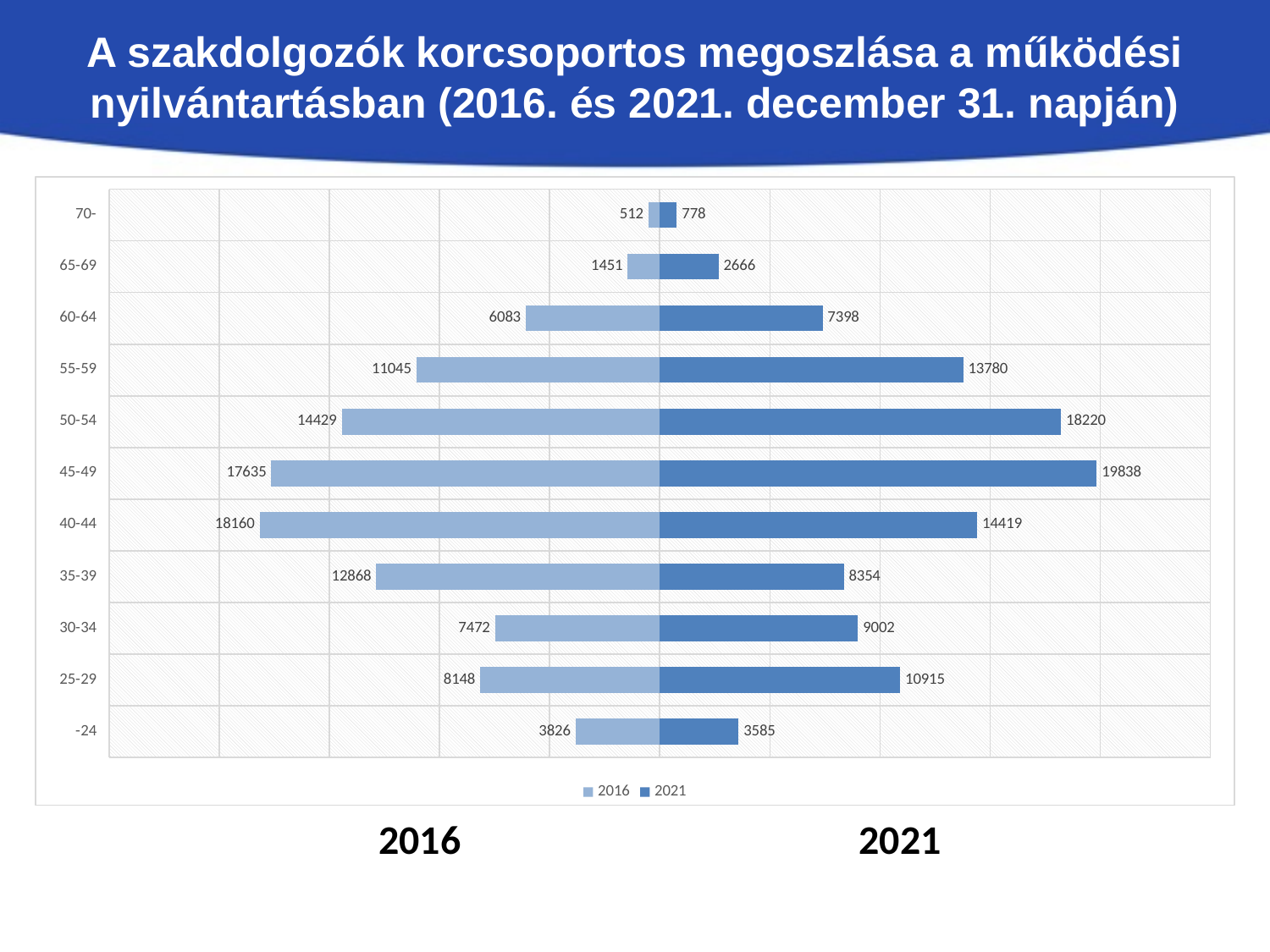
What is the 2016 value for the 45-49 age group? 17635 What is the 2021 value for the 70- age group? 778 Which age group has the lowest 2016 value? 70- What kind of chart is shown on the slide? Bar chart What is the difference between the 2021 and 2016 values for the 45-49 age group? 2203 How many age groups are shown on the chart? 11 Which age group has the highest 2021 value? 45-49 Which age group has the highest 2016 value? 40-44 For the 30-34 age group, which year has the larger value, 2016 or 2021? 2021 What is the 2021 value for the 25-29 age group? 10915 What is the difference between the 2021 and 2016 values for the 40-44 age group? 3741 How many series does the legend list? 2